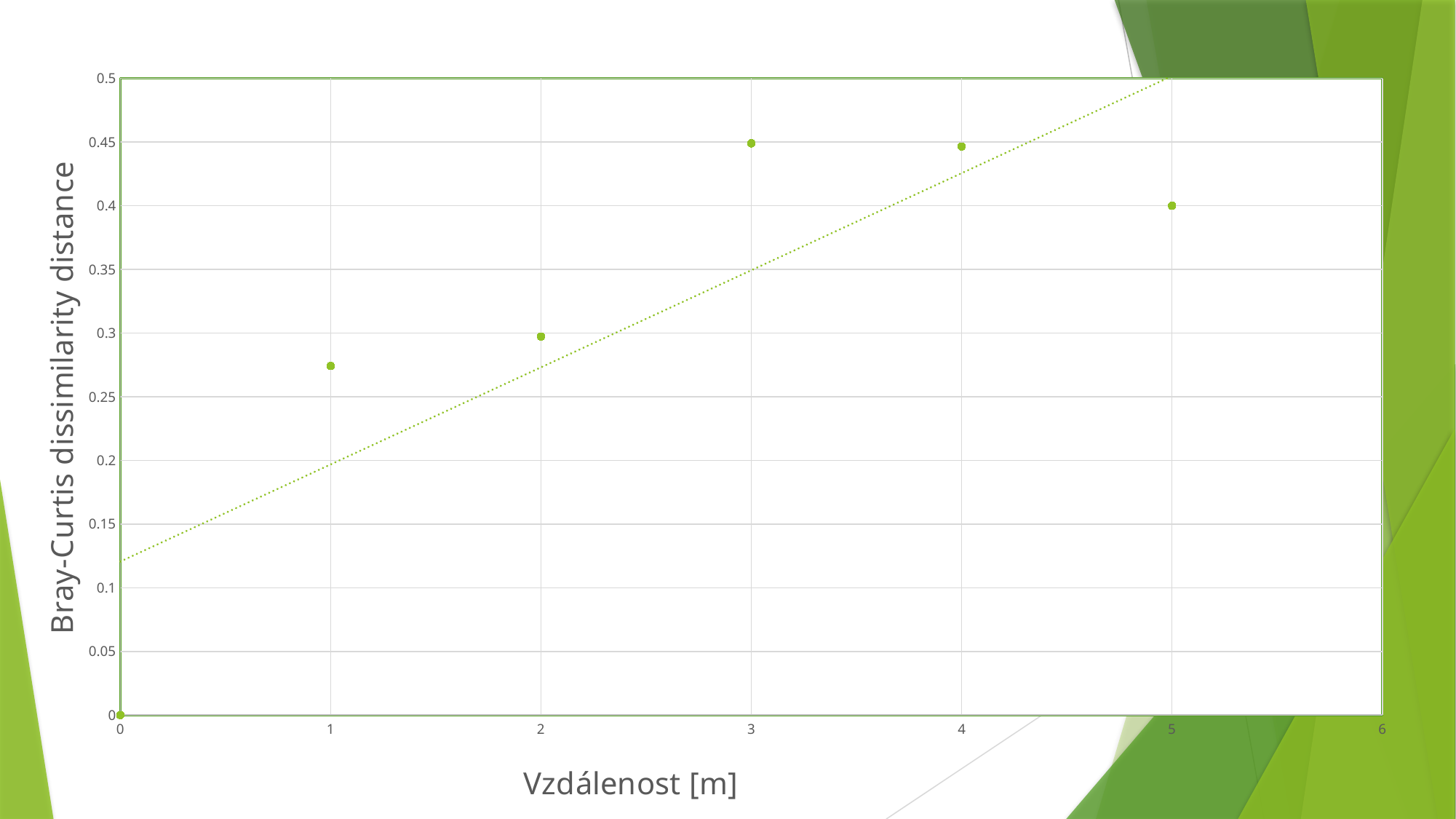
How many data points are plotted on the chart? 6 What is the Bray-Curtis dissimilarity distance at a distance of 0 m? 0 What kind of chart is shown on the slide? scatter chart At which distance is the Bray-Curtis dissimilarity distance lowest? 0 m Do the values generally rise or fall as the distance increases from 0 m to 3 m? rise What is the title of the x axis? Vzdálenost [m] Which has the larger Bray-Curtis dissimilarity distance, 3 m or 5 m? 3 m Is the value at 3 m greater or less than 0.4? greater Is the value at 1 m greater or less than 0.25? greater Which has the larger Bray-Curtis dissimilarity distance, 1 m or 5 m? 5 m Is the value at 5 m greater or less than 0.45? less